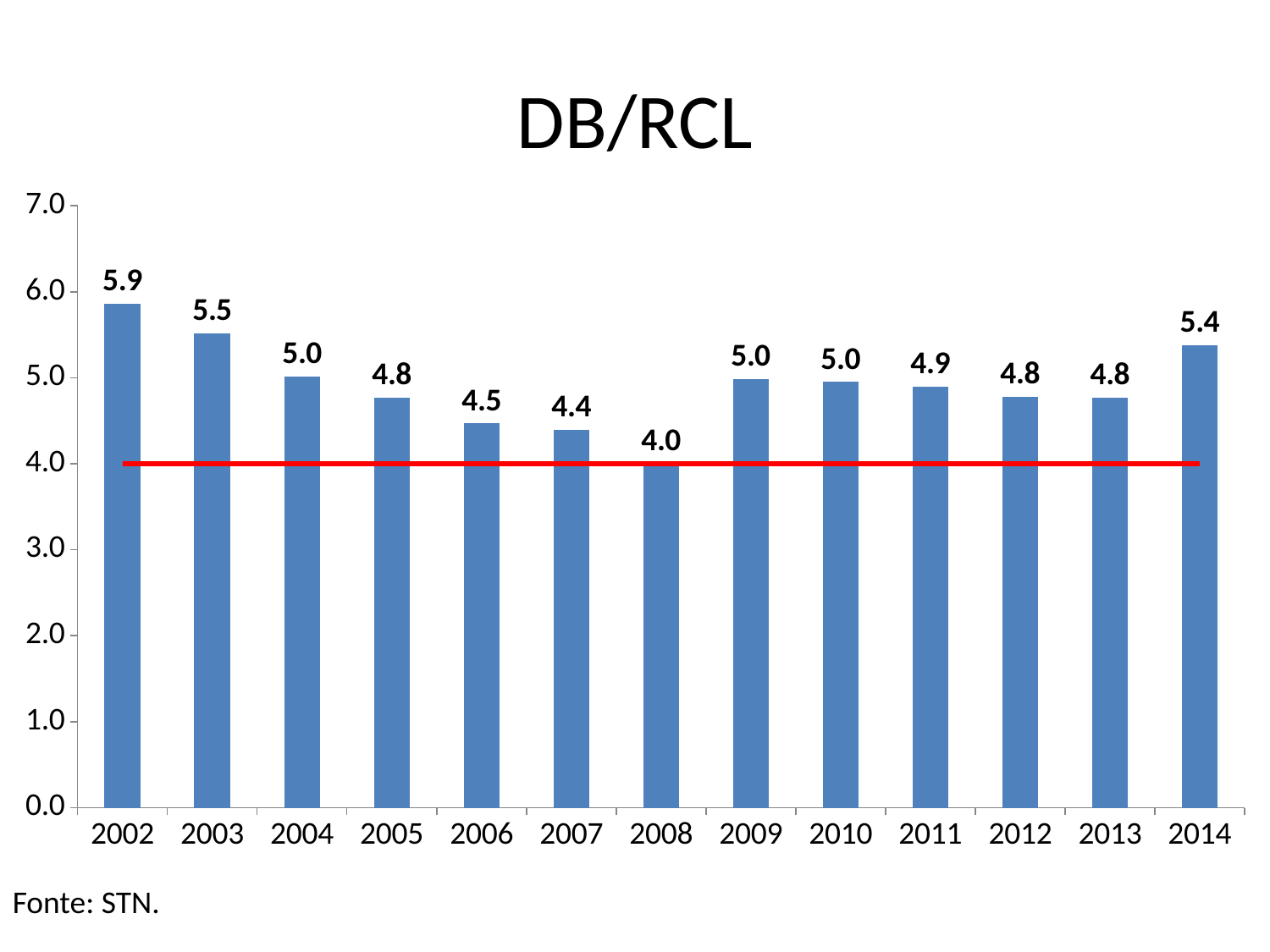
How many years are shown on the x axis? 13 What is the DB/RCL value for 2008? 4.0 Is the value for 2007 greater or less than 5.0? less What is the DB/RCL value for 2002? 5.9 Which year has the highest DB/RCL value? 2002 What is the DB/RCL value for 2014? 5.4 Which year has a larger DB/RCL value, 2003 or 2014? 2003 Which year has the lowest DB/RCL value? 2008 Do the DB/RCL values rise or fall from 2002 to 2008? fall What is the title of the chart? DB/RCL What kind of chart is shown on the slide? bar chart What is the difference between the DB/RCL values for 2002 and 2008? 1.9